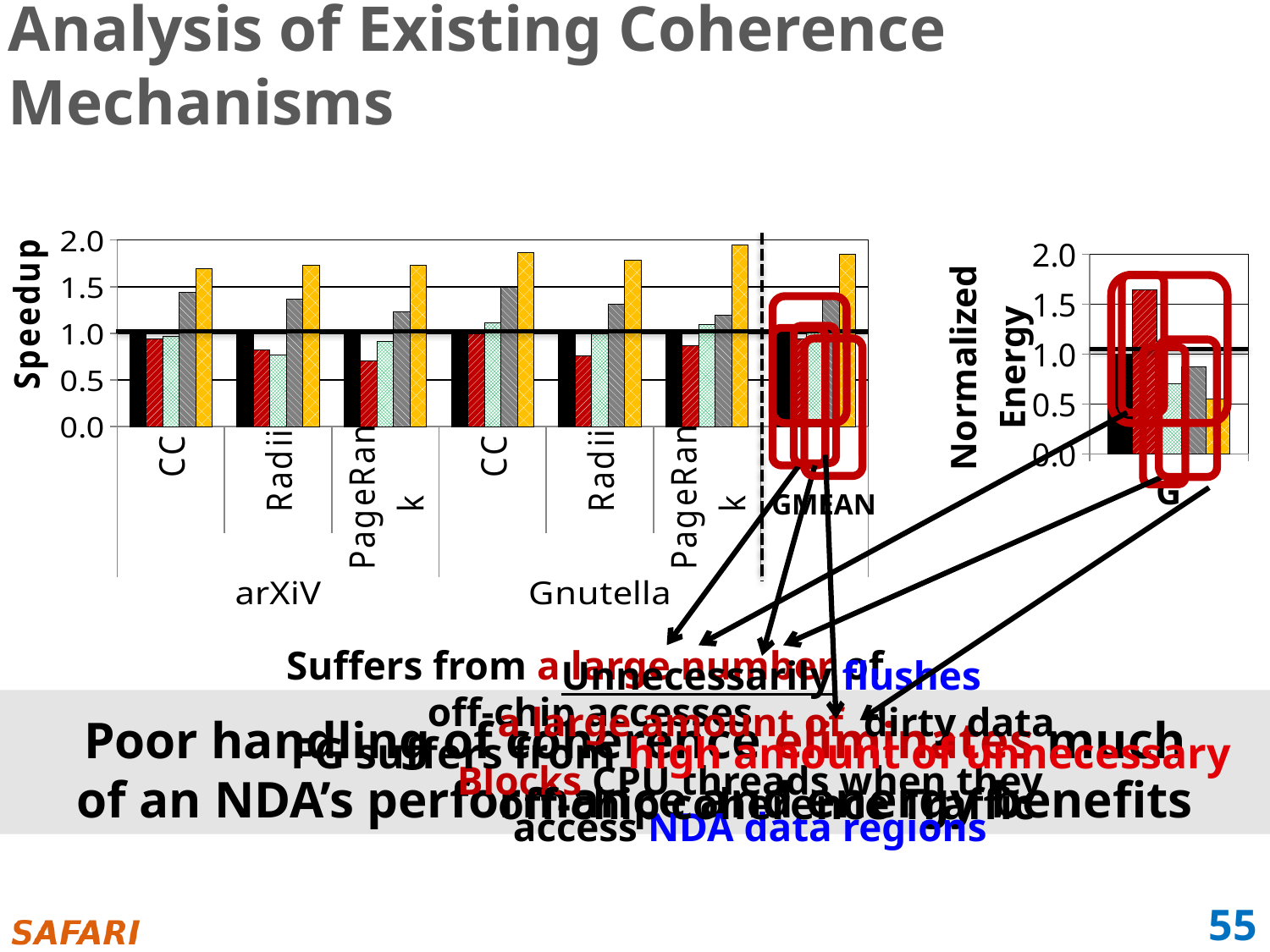
In the Normalized Energy chart, is the red hatched bar greater or less than 1.5? greater In the Speedup chart, how many bars are plotted in each group? 5 In the Speedup chart, which two workload families are the benchmarks grouped under? arXiV and Gnutella In the Speedup chart, is the yellow bar for PageRank under Gnutella greater or less than 1.5? greater In the Speedup chart, how many groups of bars are plotted, including GMEAN? 7 In the chart on the right, what is the label of the y axis? Normalized Energy In the Speedup chart, what is the label of the y axis? Speedup In the Speedup chart, is the yellow bar for CC under arXiV greater or less than 1.5? greater What kind of chart is the Speedup chart on the left? bar chart What kind of chart is the Normalized Energy chart on the right? bar chart In the Speedup chart, what is the highest value shown on the y axis? 2.0